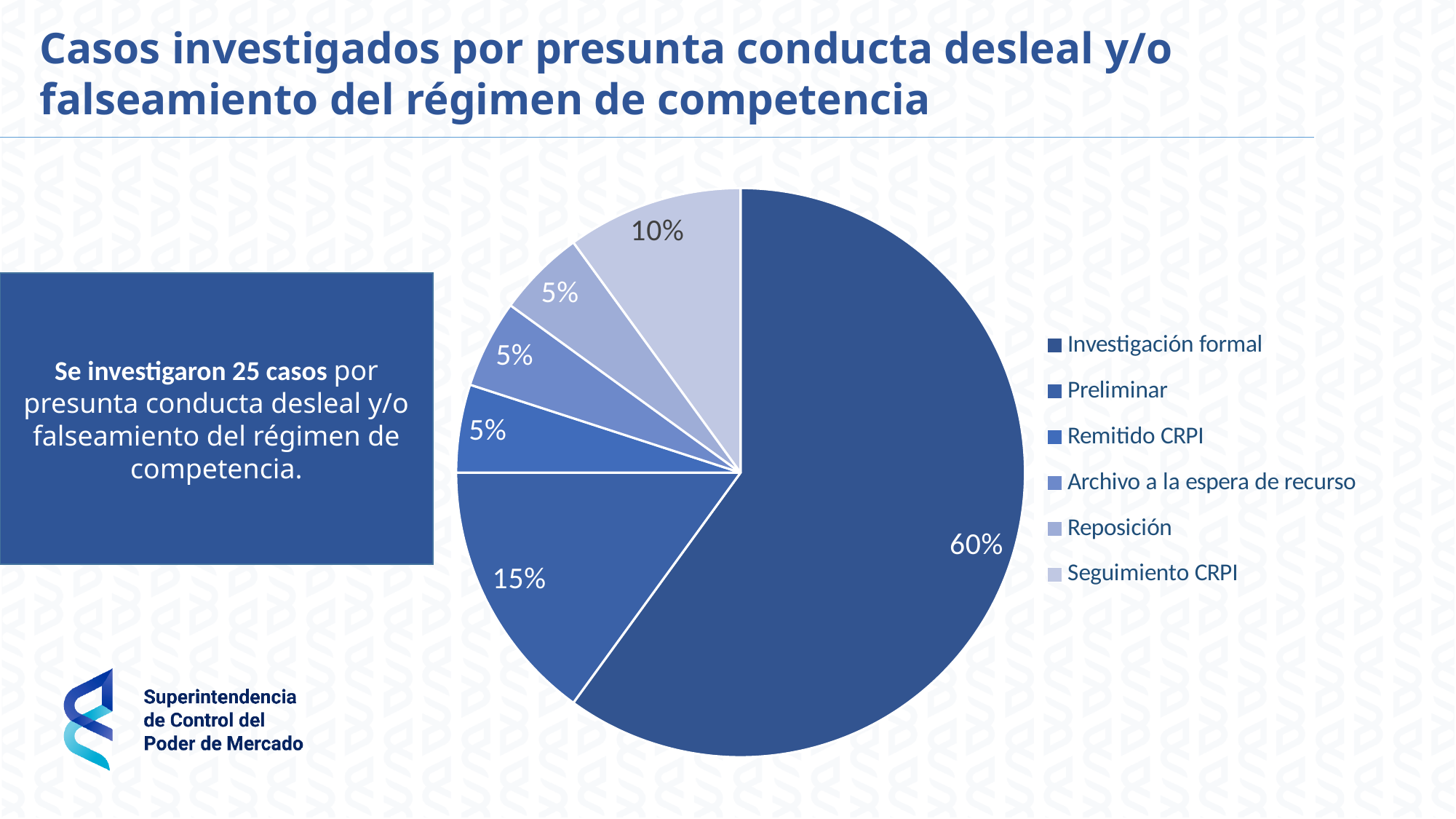
How many categories does the legend list? 6 What is the combined share of Preliminar and Seguimiento CRPI? 25% What share of the pie does Preliminar represent? 15% What kind of chart is shown on the slide? Pie chart What is the value shown for Reposición? 5% Which category has the largest slice of the pie? Investigación formal What share of the pie does Investigación formal represent? 60% Which legend entry is listed last? Seguimiento CRPI What share of the pie does Seguimiento CRPI represent? 10% What is the difference between the Investigación formal share and the Preliminar share? 45% What is the value shown for Remitido CRPI? 5% Which is larger, the share for Preliminar or the share for Seguimiento CRPI? Preliminar